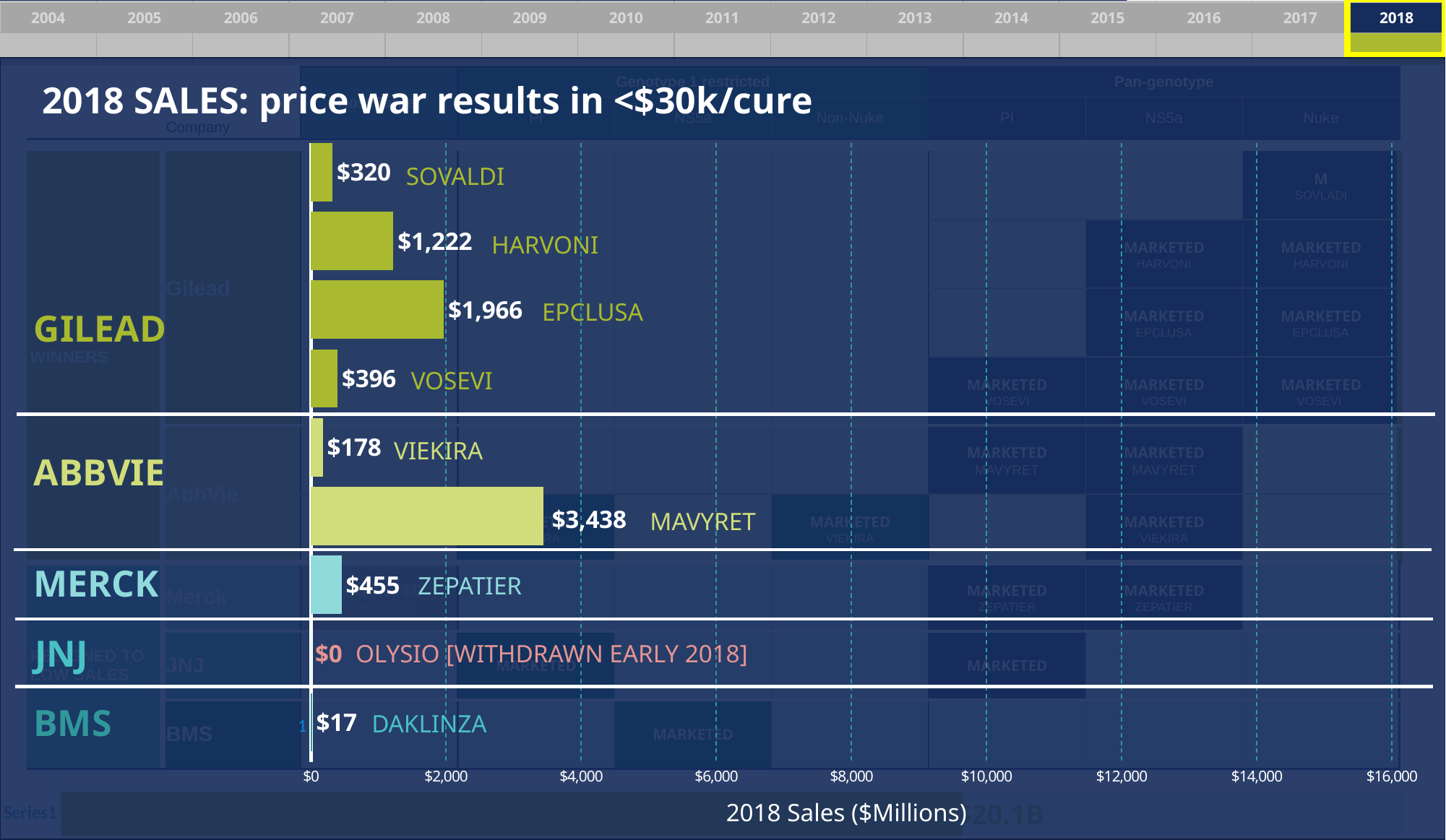
What is the difference in 2018 sales between MAVYRET and EPCLUSA? $1,472 Is the value for HARVONI greater or less than $2,000? less What kind of chart is shown on the slide? bar chart What are the 2018 sales for ZEPATIER? $455 Which has higher 2018 sales, HARVONI or VOSEVI? HARVONI What is the label of the horizontal axis? 2018 Sales ($Millions) Which drug has the highest 2018 sales? MAVYRET What are the 2018 sales for DAKLINZA? $17 What are the 2018 sales for EPCLUSA? $1,966 Which drug has the lowest 2018 sales? OLYSIO What are the 2018 sales for MAVYRET? $3,438 How many drugs are plotted in the chart? 9